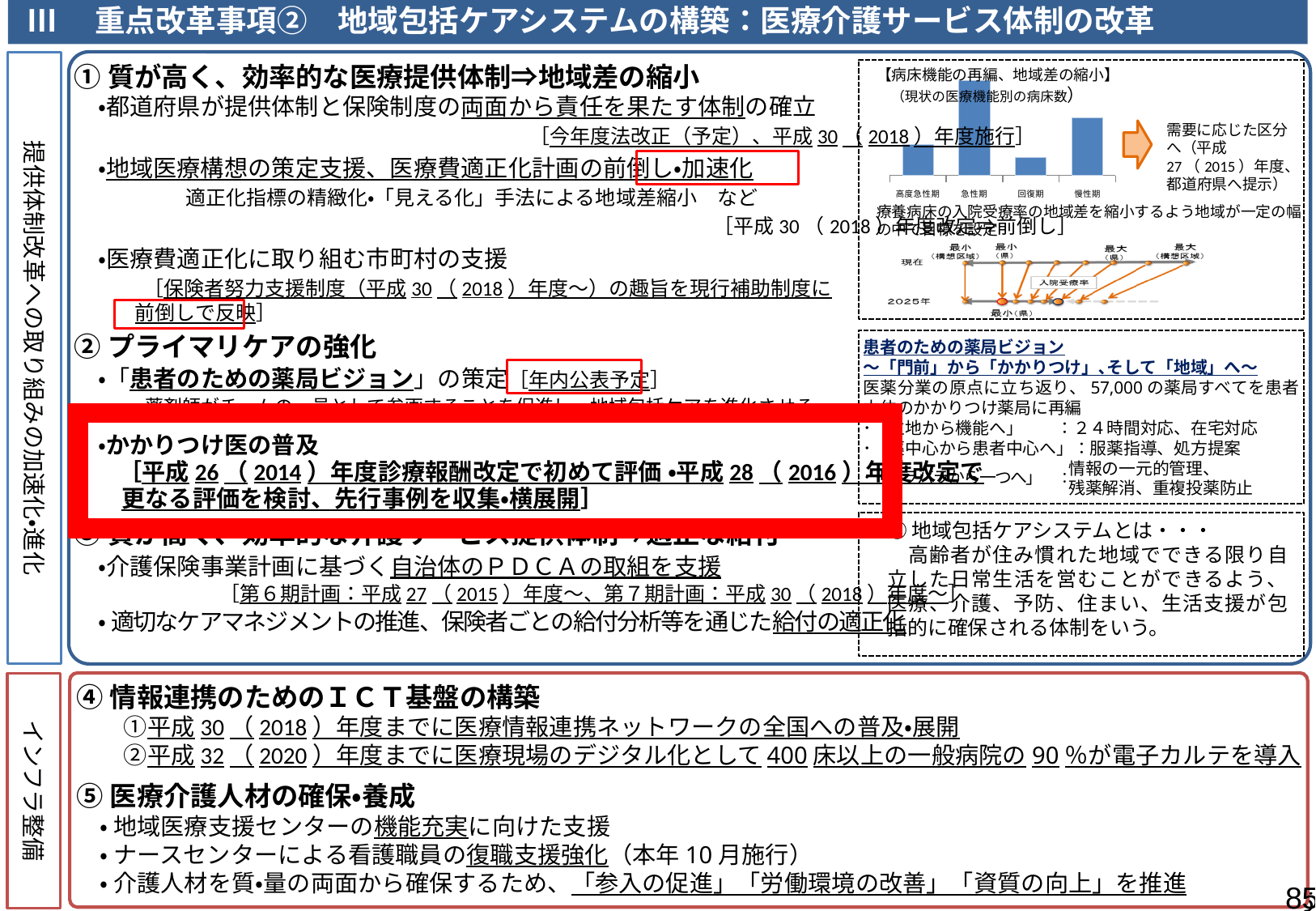
In the 現状の医療機能別の病床数 bar chart, which is larger, 急性期 or 回復期? 急性期 In the 現状の医療機能別の病床数 bar chart, which is larger, 慢性期 or 高度急性期? 慢性期 How many categories are shown on the x axis of the 現状の医療機能別の病床数 bar chart? 4 In the 現状の医療機能別の病床数 bar chart, which is larger, 慢性期 or 回復期? 慢性期 What kind of chart is shown in the top-right box titled 現状の医療機能別の病床数? bar chart What is the label of the last (rightmost) category in the 現状の医療機能別の病床数 bar chart? 慢性期 What is the label of the first (leftmost) category in the 現状の医療機能別の病床数 bar chart? 高度急性期